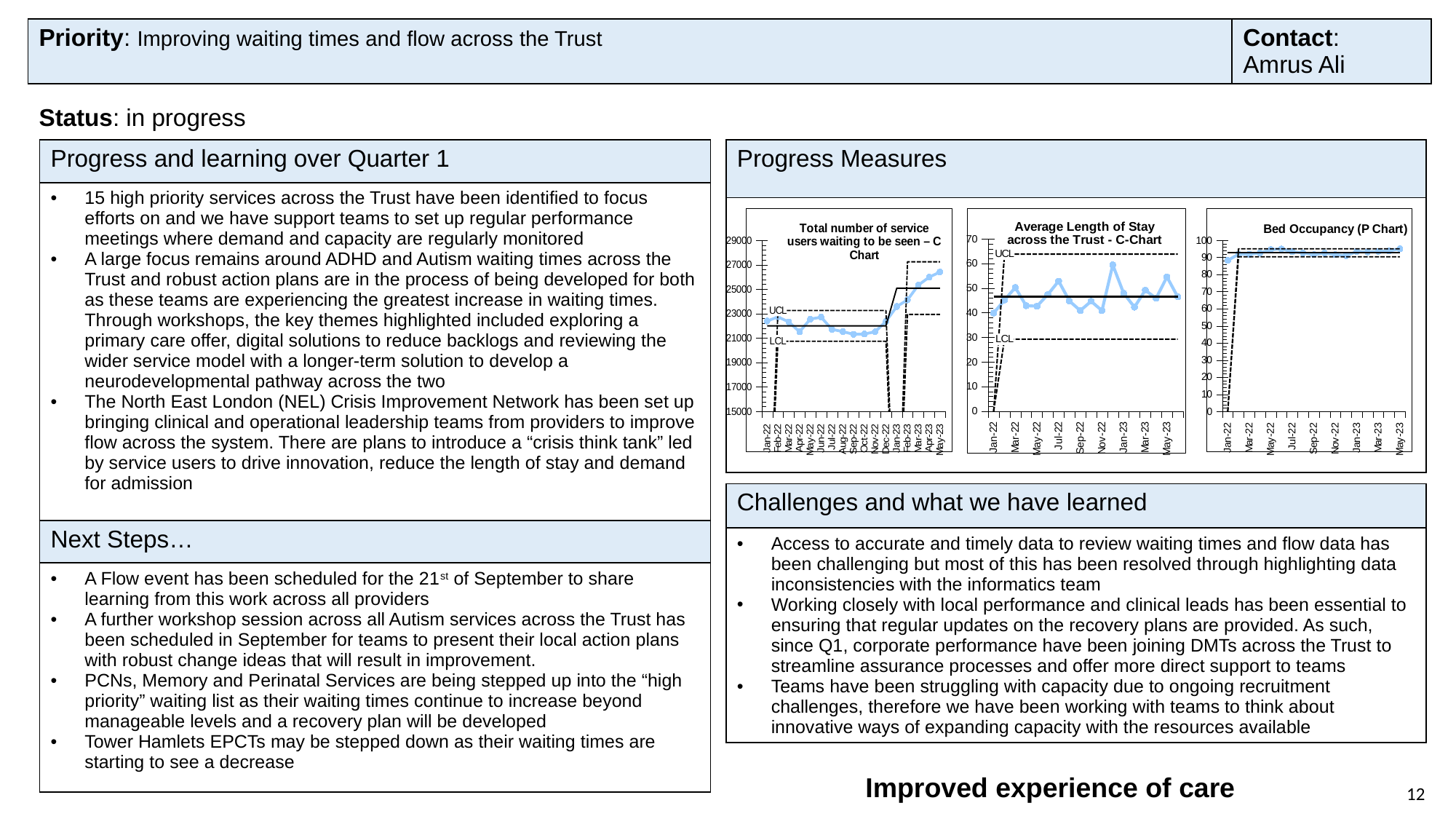
In the 'Total number of service users waiting to be seen – C Chart', do the values generally rise or fall from Jan-22 to May-23? rise How many charts are shown in the Progress Measures section of the slide? 3 In the 'Bed Occupancy (P Chart)', is the value for May-23 greater or less than 80? greater What is the highest y-axis tick shown on the 'Average Length of Stay across the Trust - C-Chart'? 70 In the 'Average Length of Stay across the Trust - C-Chart', is the value for Jan-22 greater or less than 50? less What is the title of the rightmost chart in the Progress Measures section? Bed Occupancy (P Chart) In the 'Total number of service users waiting to be seen – C Chart', is the value for May-23 greater or less than 25000? greater What kind of chart is the 'Total number of service users waiting to be seen – C Chart'? line chart